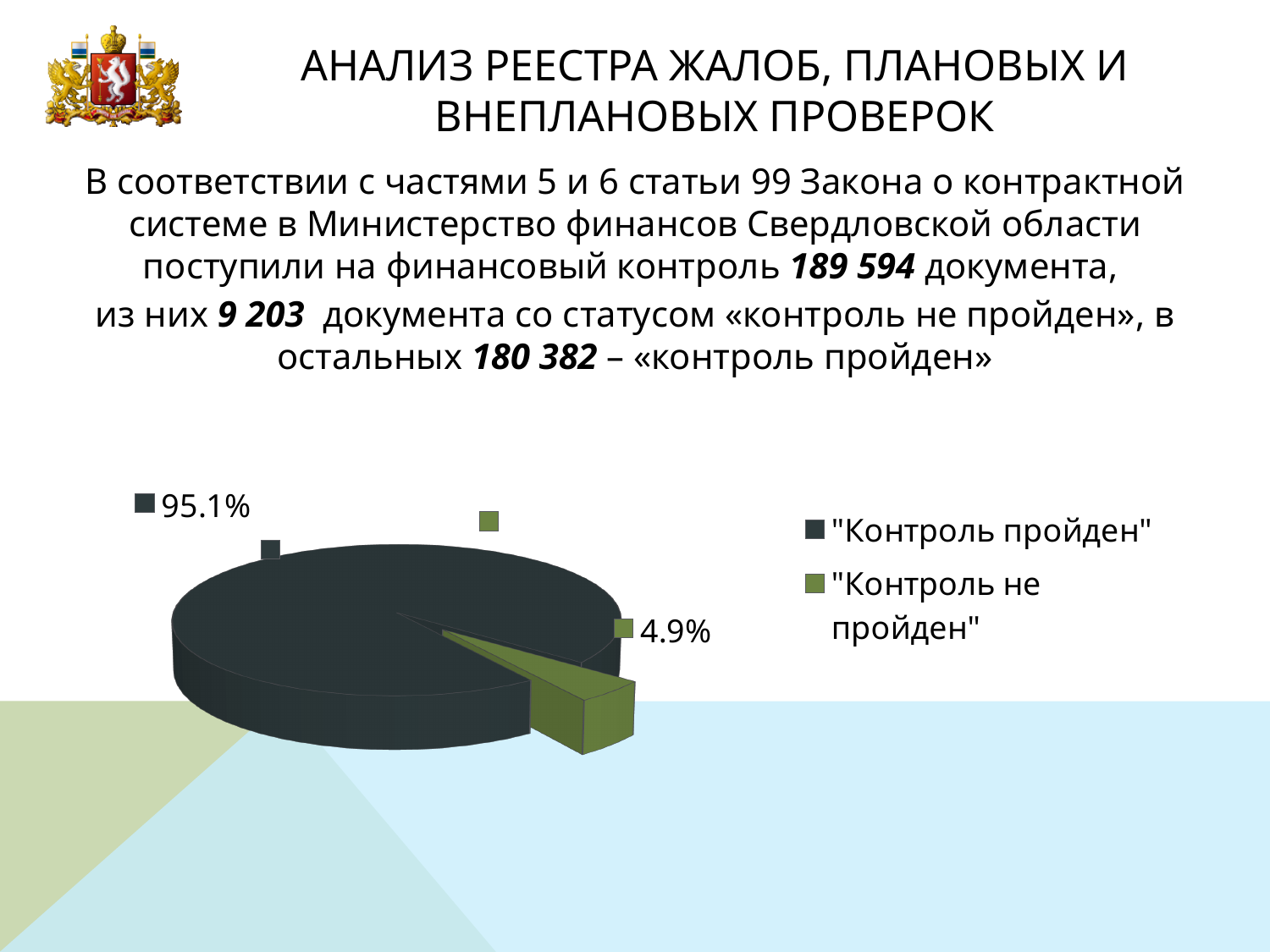
Which slice of the pie is the largest? "Контроль пройден" Which slice of the pie is the smallest? "Контроль не пройден" How many entries does the legend list? 2 How many slices does the pie chart have? 2 What is the difference in percentage points between the "Контроль пройден" and "Контроль не пройден" slices? 90.2 What share of the pie does "Контроль пройден" represent? 95.1% Which legend entry is shown in green? "Контроль не пройден" What share of the pie does "Контроль не пройден" represent? 4.9% What kind of chart is shown on the slide? Pie chart Which is larger, the "Контроль пройден" slice or the "Контроль не пройден" slice? "Контроль пройден" What is the value shown for the "Контроль пройден" slice? 95.1% What is the value shown for the "Контроль не пройден" slice? 4.9%